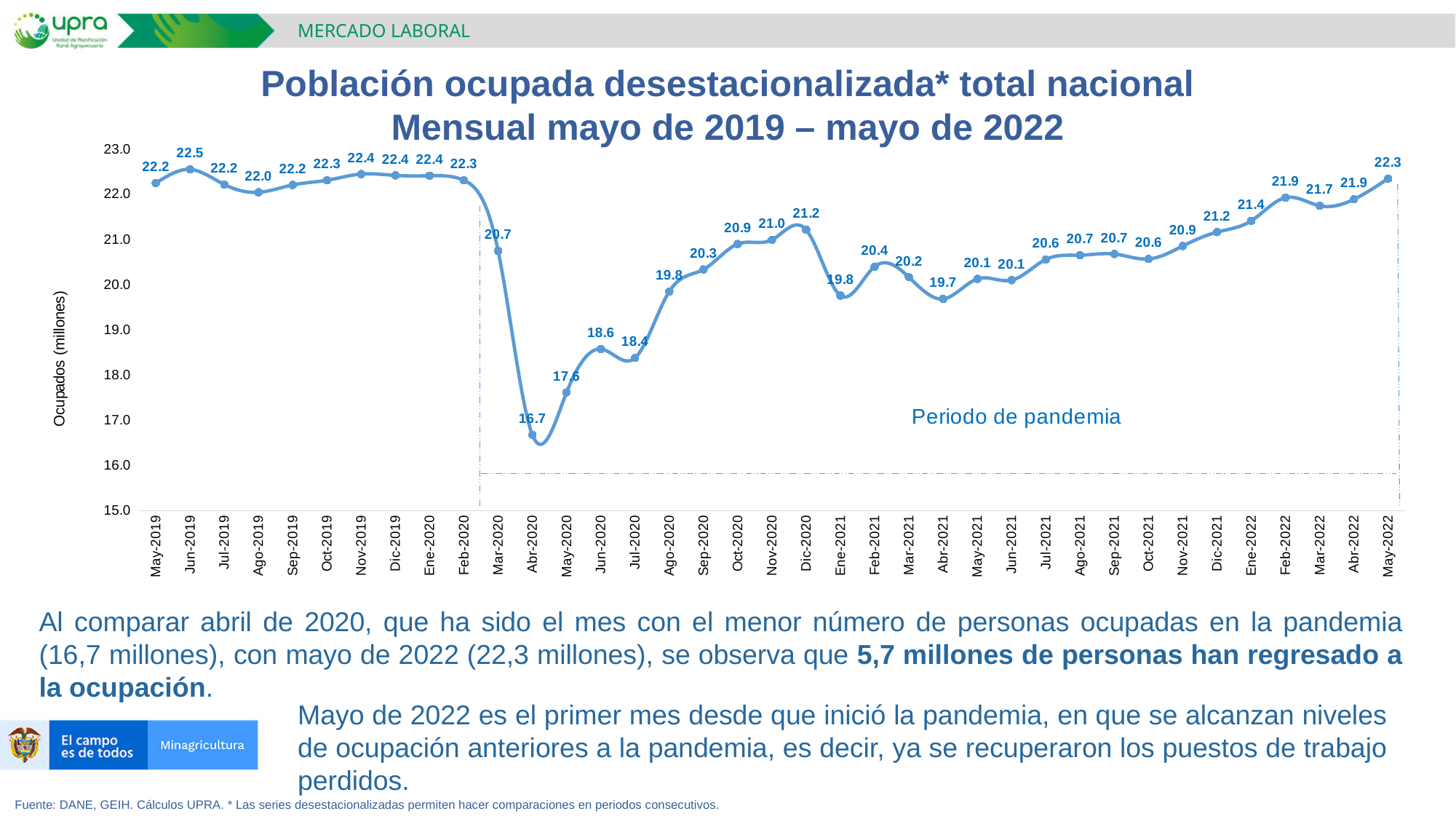
Which month has the highest value on the chart? Jun-2019 What is the value for May-2022? 22.3 What is the value for Abr-2020? 16.7 Do the values rise or fall from Abr-2020 to Dic-2020? rise What is the value for Dic-2020? 21.2 What type of chart is shown on the slide? line chart Is the value for Jul-2020 greater or less than 19.0? less What is the label of the y-axis? Ocupados (millones) What is the difference between the values for May-2022 and Abr-2020? 5.6 Which is larger, the value for Feb-2022 or the value for Mar-2022? Feb-2022 How many monthly data points are plotted on the chart? 37 Which month has the lowest value on the chart? Abr-2020